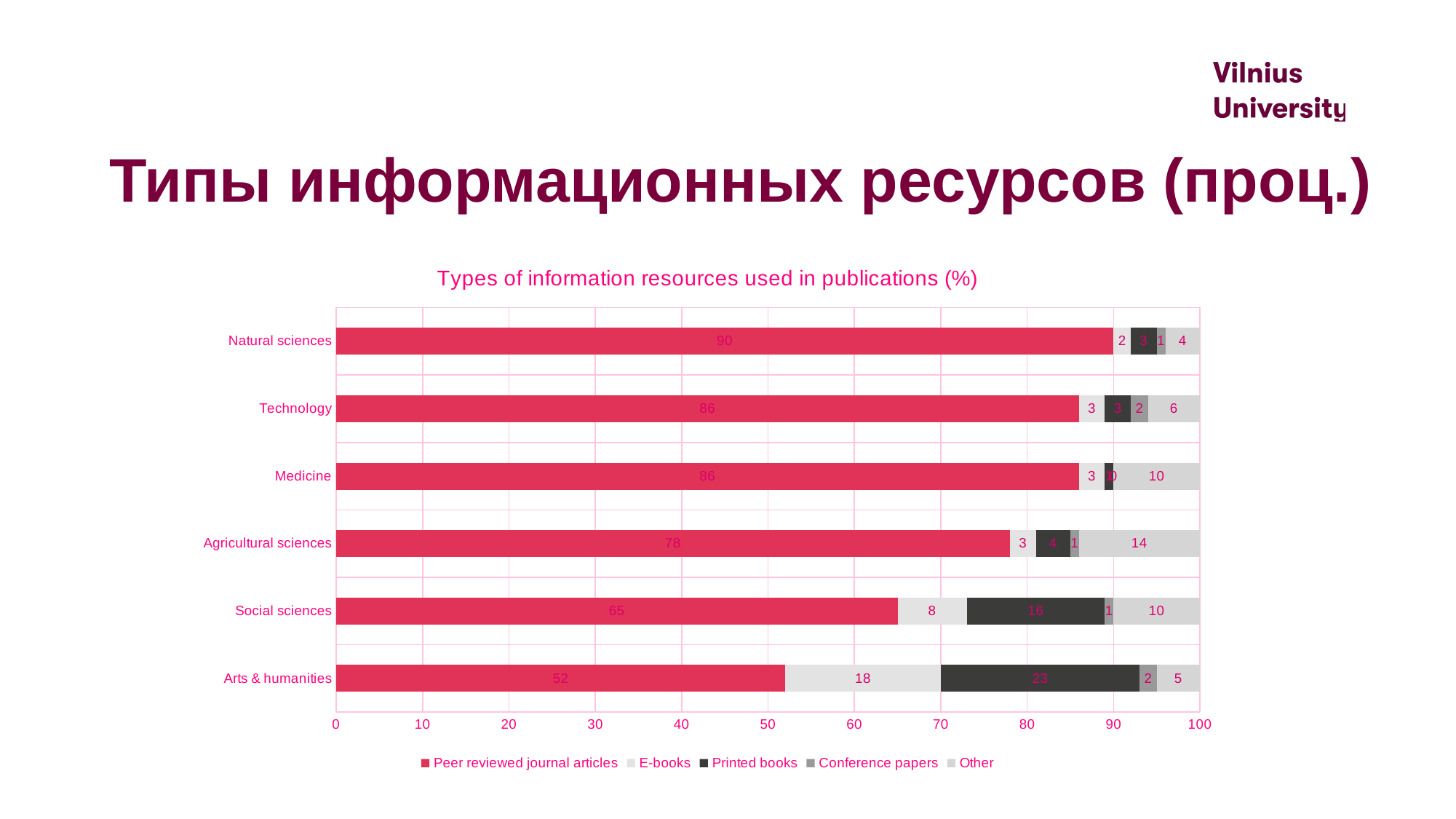
What is the difference between the Peer reviewed journal articles values for Natural sciences and Arts & humanities? 38 What is the value for Peer reviewed journal articles in Natural sciences? 90 What is the value for E-books in Social sciences? 8 What is the total of the stacked bar for Social sciences? 100 What kind of chart is shown on the slide? Stacked bar chart What is the value for Other in Agricultural sciences? 14 Which is larger: the Printed books value for Social sciences or for Arts & humanities? Arts & humanities How many series does the legend list? 5 Which category has the highest value for Peer reviewed journal articles? Natural sciences What is the value for Printed books in Arts & humanities? 23 How many categories are shown on the y axis? 6 Which category has the lowest value for Peer reviewed journal articles? Arts & humanities